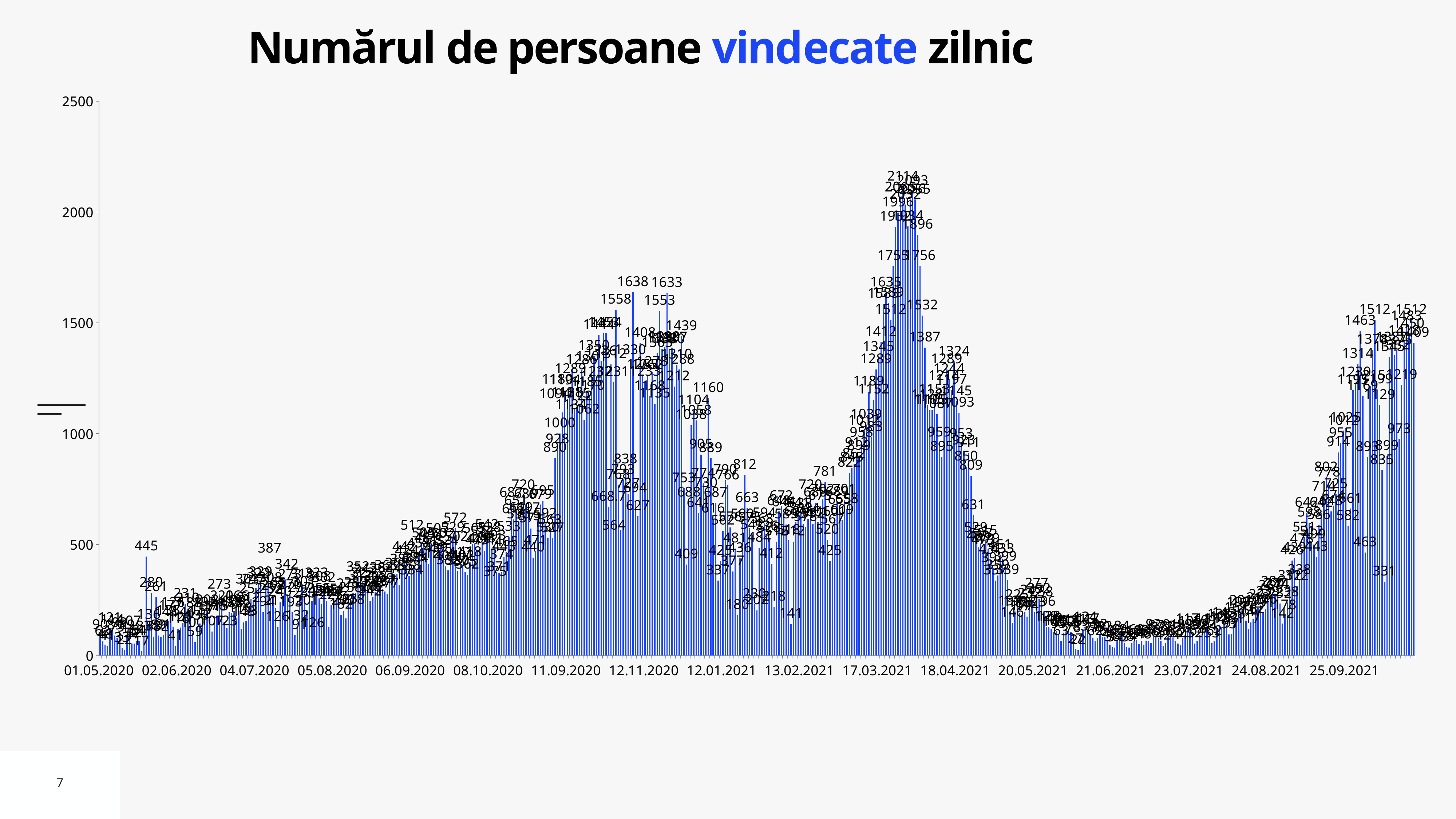
What is the maximum value shown on the vertical axis? 2500 Do the values rise or fall between 24.08.2021 and 25.09.2021? rise What is the title of the chart? Numărul de persoane vindecate zilnic Are the values around 18.04.2021 greater or less than 1000? greater Are the values around 21.06.2021 greater or less than 500? less What is the difference between the highest labelled value of the spring 2021 peak (2114) and the highest labelled value of the November 2020 peak (1638)? 476 Is the highest value on the chart greater or less than 2000? greater What kind of chart is shown on the slide? bar chart What is the highest daily value labelled on the chart? 2114 How many date labels are shown on the horizontal axis? 17 Do the values rise or fall between 20.05.2021 and 21.06.2021? fall Which peak is higher: the one around 17.03.2021–18.04.2021 or the one around 12.11.2020? the one around 17.03.2021–18.04.2021